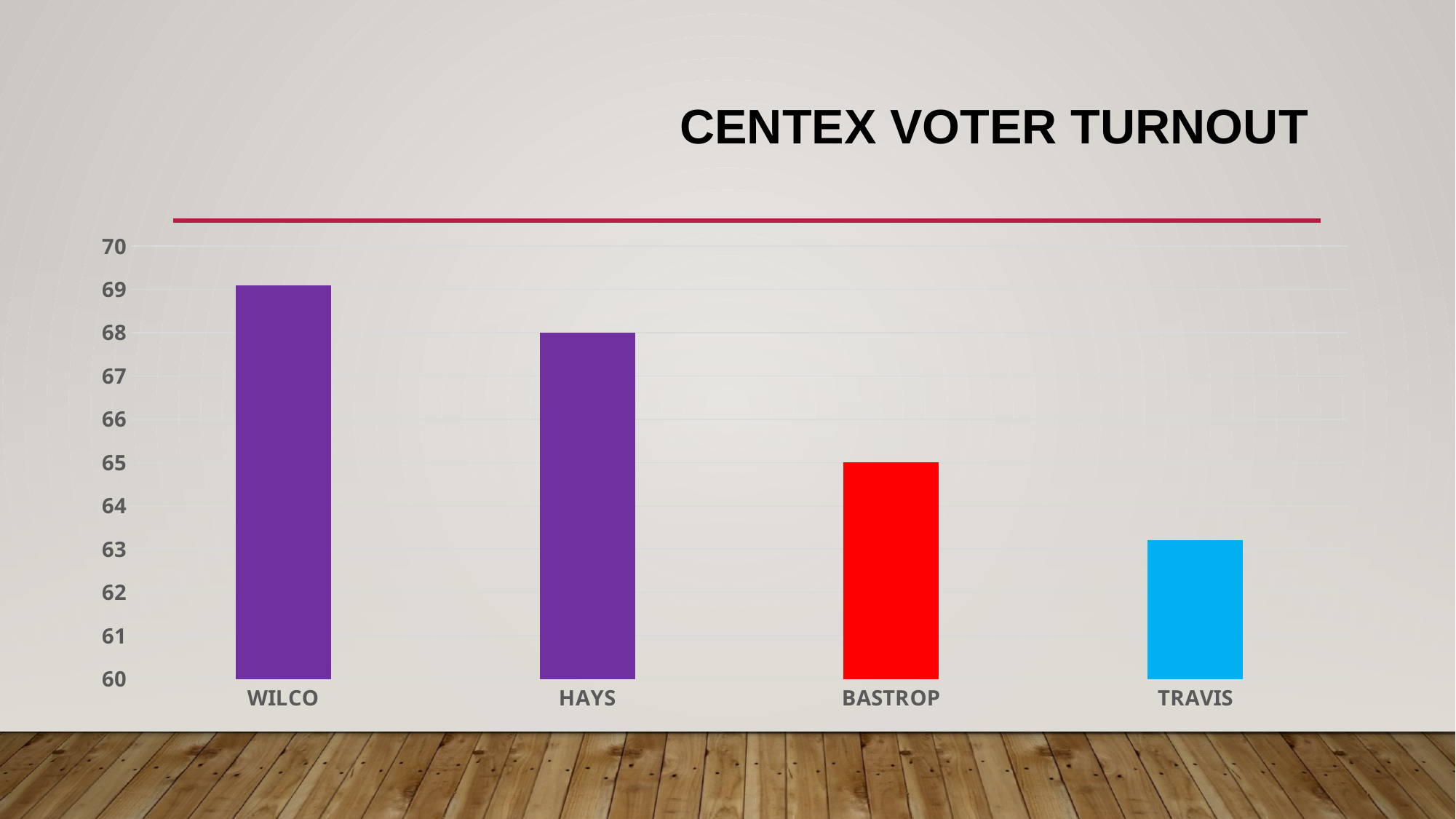
Is the value for TRAVIS greater or less than 64? less Which is larger, the value for HAYS or the value for BASTROP? HAYS Which county has the highest voter turnout? WILCO What colour is the bar for BASTROP? red Do the values rise or fall from left to right across the counties? fall Which county has the lowest voter turnout? TRAVIS What is the title of the chart? CENTEX VOTER TURNOUT What kind of chart is shown on the slide? bar chart What is the value for BASTROP? 65 What is the value for HAYS? 68 How many counties are shown on the chart? 4